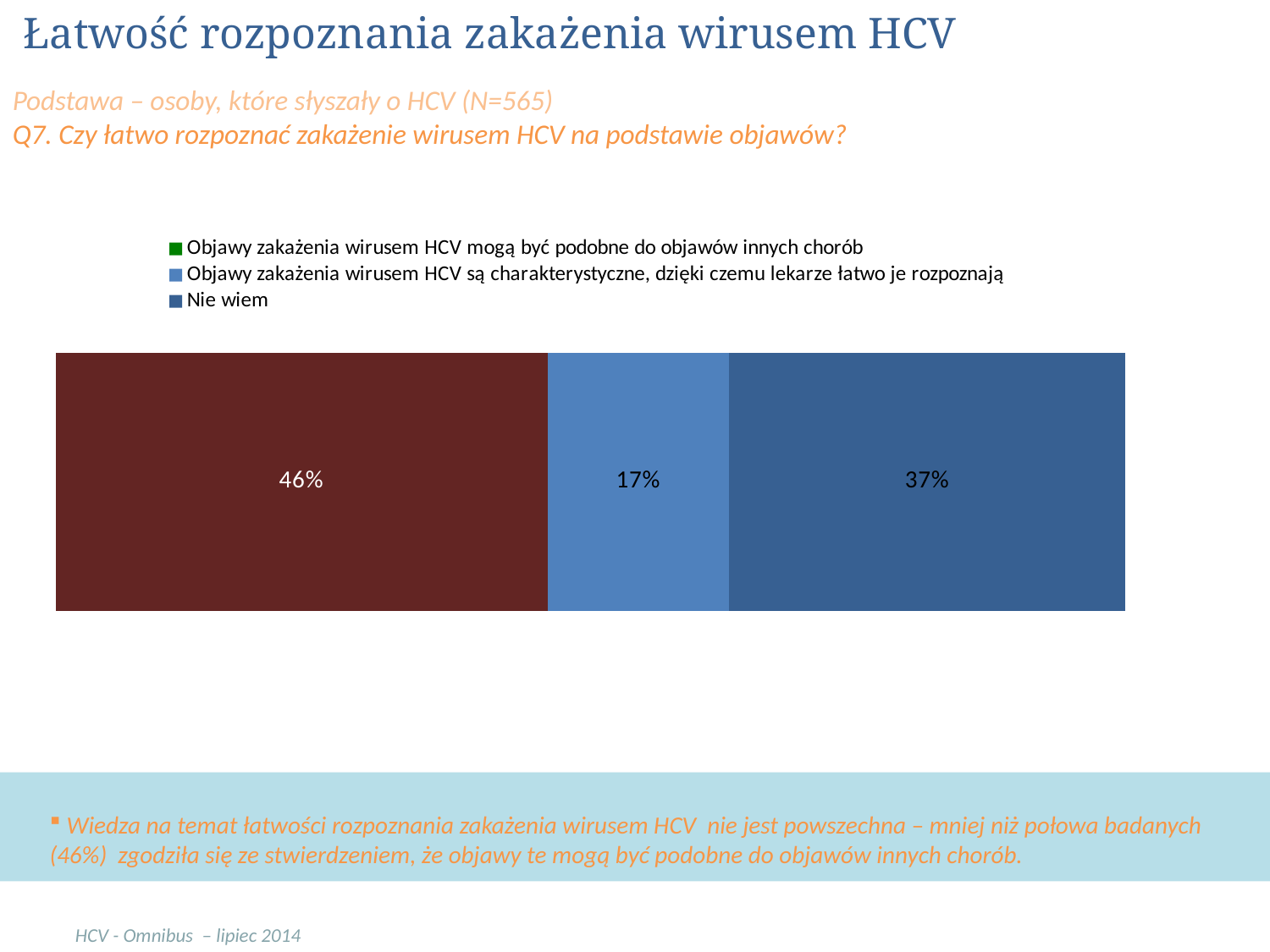
What is the sample size (N) stated in the subtitle of the slide? N=565 What is the total of the three segments in the stacked bar? 100% What is the difference in percentage points between the 'Nie wiem' share and the share saying symptoms are characteristic? 20 percentage points Which is larger: the share answering 'Nie wiem' or the share saying HCV symptoms are characteristic? Nie wiem What type of chart is shown on the slide? Stacked bar chart Which answer option has the smallest share in the bar? Objawy zakażenia wirusem HCV są charakterystyczne, dzięki czemu lekarze łatwo je rozpoznają What percentage of respondents said that symptoms of HCV infection may be similar to symptoms of other diseases (Objawy zakażenia wirusem HCV mogą być podobne do objawów innych chorób)? 46% Which answer option has the largest share in the bar? Objawy zakażenia wirusem HCV mogą być podobne do objawów innych chorób How many series does the legend list? 3 What is the difference in percentage points between the largest segment and the 'Nie wiem' segment? 9 percentage points What percentage of respondents answered 'Nie wiem'? 37% What percentage of respondents said that symptoms of HCV infection are characteristic so doctors recognise them easily (Objawy zakażenia wirusem HCV są charakterystyczne)? 17%